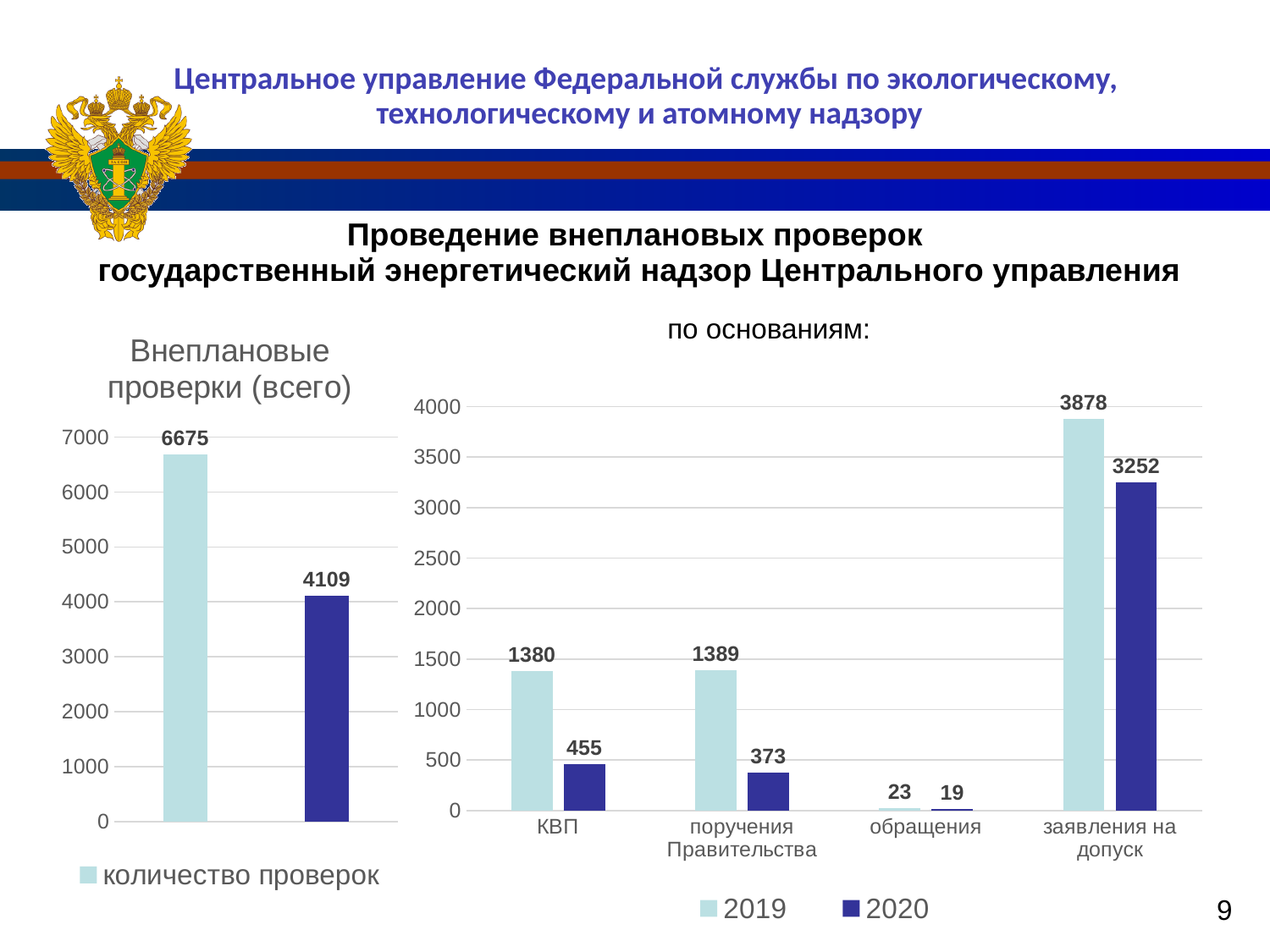
In the chart titled 'по основаниям:', how many categories are shown on the x axis? 4 In the chart titled 'Внеплановые проверки (всего)', what is the value of the taller bar? 6675 What kind of chart is the chart titled 'Внеплановые проверки (всего)'? bar chart In the chart titled 'по основаниям:', what is the 2020 value for обращения? 19 In the chart titled 'по основаниям:', which category has the highest 2019 value? заявления на допуск In the chart titled 'по основаниям:', how many series does the legend list? 2 In the chart titled 'Внеплановые проверки (всего)', what is the difference between the two bars? 2566 In the chart titled 'по основаниям:', which is larger for КВП: the 2019 value or the 2020 value? 2019 In the chart titled 'по основаниям:', what is the 2019 value for КВП? 1380 In the chart titled 'по основаниям:', what is the 2020 value for заявления на допуск? 3252 In the chart titled 'по основаниям:', what is the difference between the 2019 and 2020 values for поручения Правительства? 1016 In the chart titled 'по основаниям:', which category has the lowest 2020 value? обращения